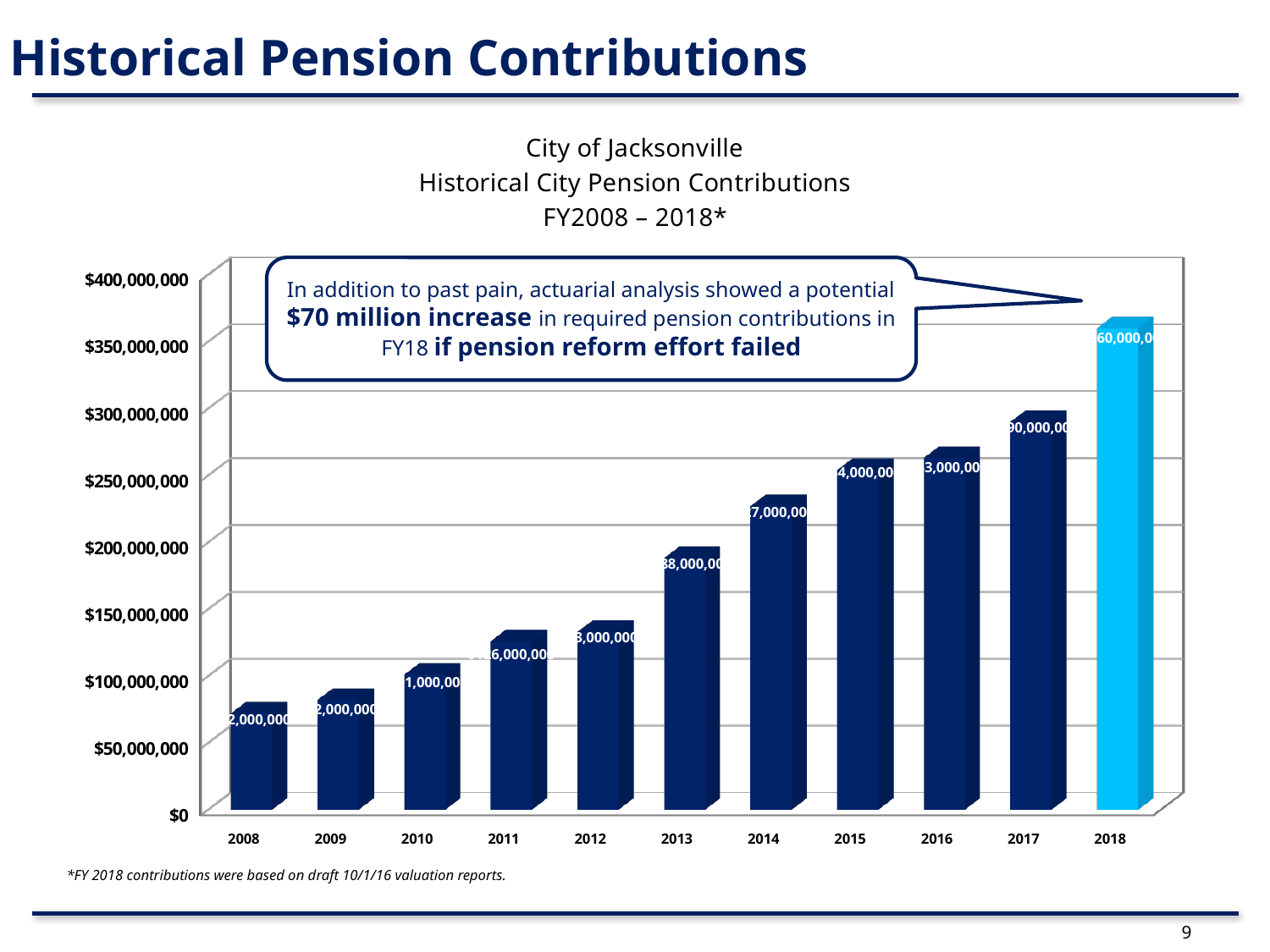
Is the value for 2008 greater or less than $100,000,000? less What kind of chart is shown on the slide? bar chart Is the value for 2018 greater or less than $350,000,000? greater Do the pension contributions rise or fall from 2008 to 2018? rise Which is larger, the contribution for 2015 or for 2013? 2015 Which year has the lowest pension contribution? 2008 Which year has the highest pension contribution? 2018 Is the value for 2011 greater or less than $100,000,000? greater How many years (bars) are plotted on the chart? 11 Which year's bar is drawn in a different (light blue) colour from the others? 2018